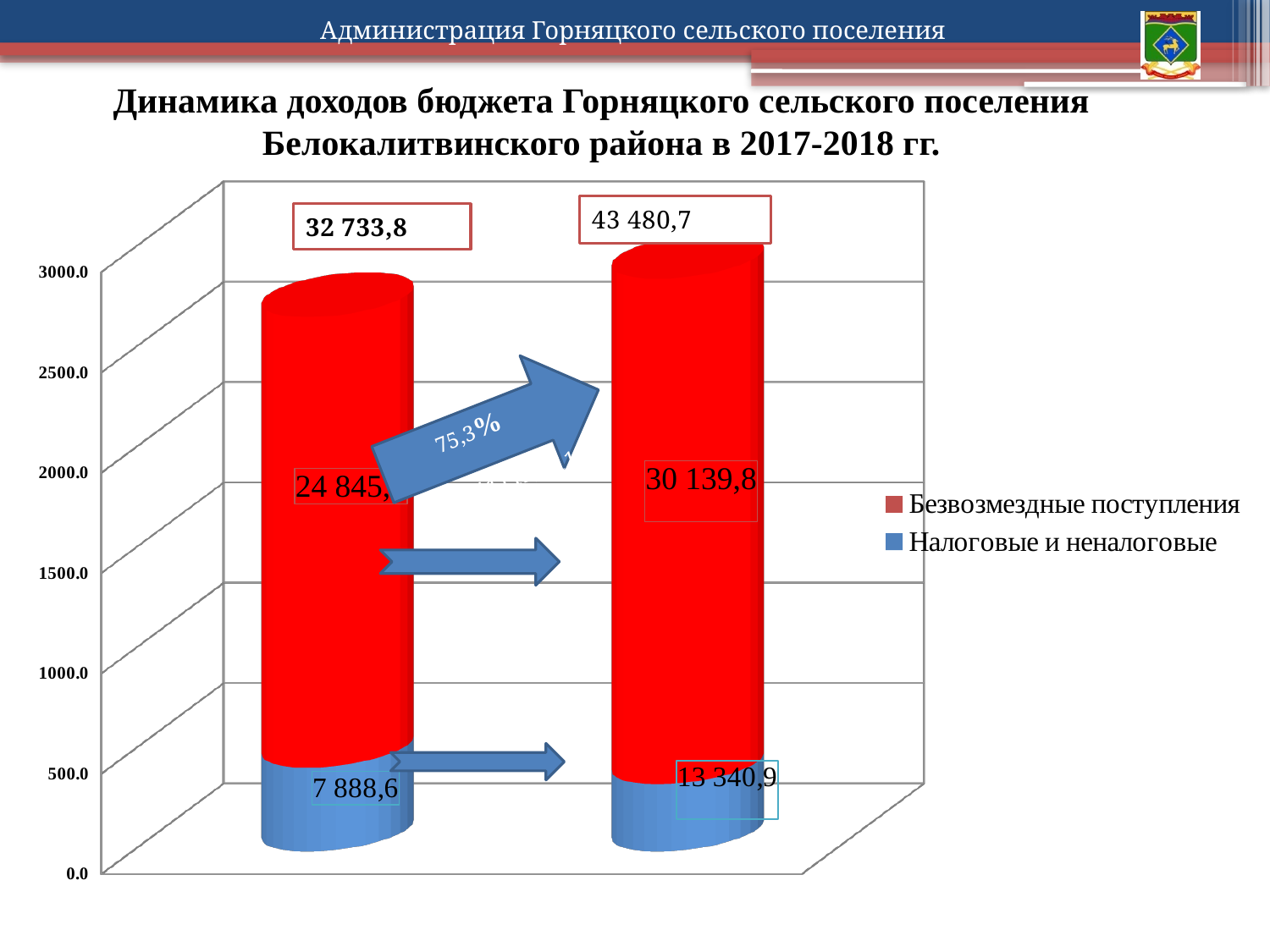
How many stacked bars are plotted in the chart? 2 Which colour represents Безвозмездные поступления in the legend? red What kind of chart is shown on the slide? bar chart What is the value of Налоговые и неналоговые for the left bar? 7 888,6 What is the difference between the totals of the right bar and the left bar? 10 746,9 By how much does Налоговые и неналоговые in the right bar exceed that in the left bar? 5 452,3 How many series does the legend list? 2 What is the value of Налоговые и неналоговые for the right bar? 13 340,9 What is the total shown above the right stacked bar? 43 480,7 What is the total shown above the left stacked bar? 32 733,8 Which bar has the larger value for Налоговые и неналоговые, the left or the right? right What is the value of Безвозмездные поступления for the right bar? 30 139,8